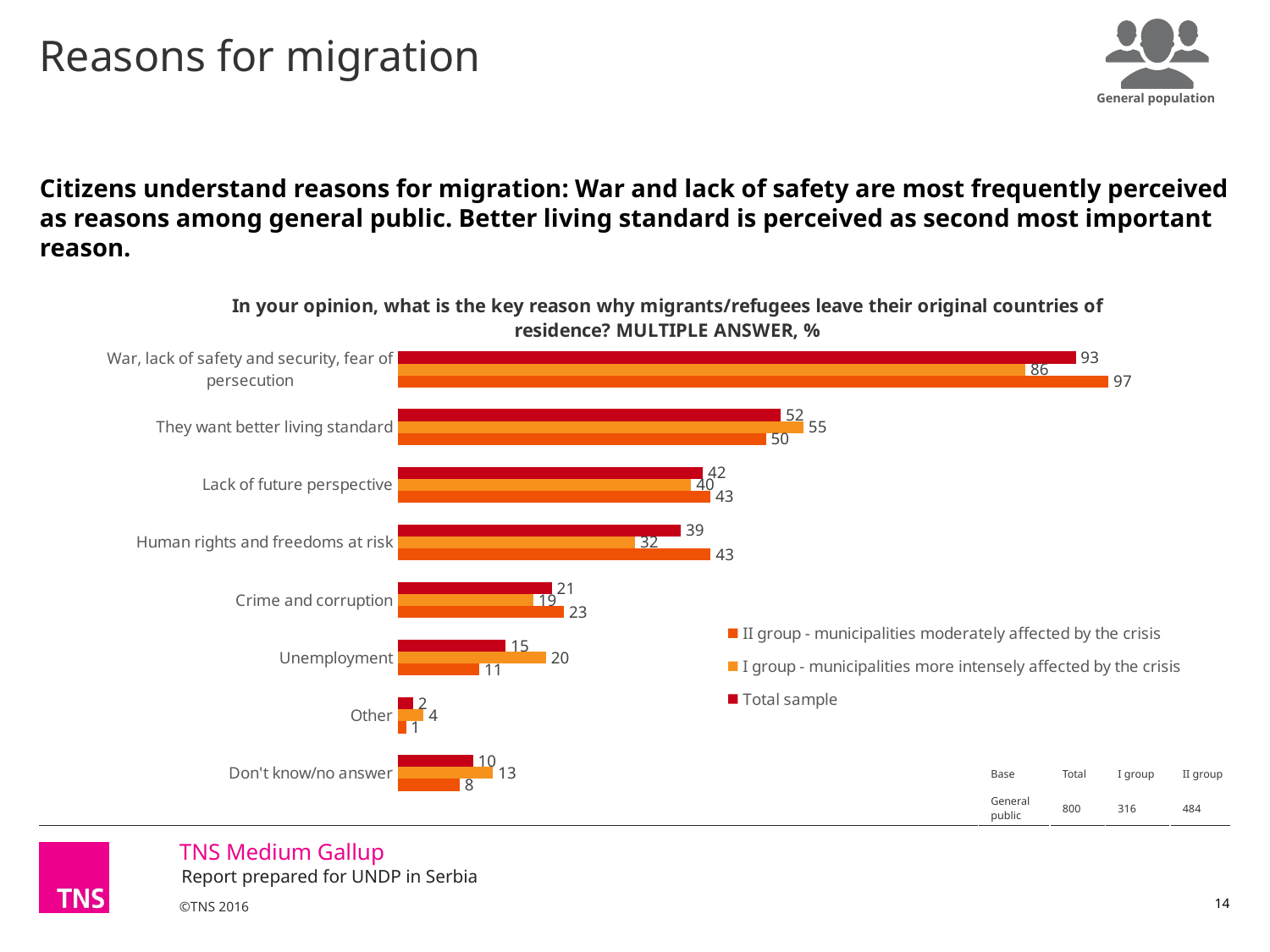
How many reason categories are shown on the chart? 8 What is the value for "They want better living standard" in the I group (municipalities more intensely affected by the crisis)? 55 Which category has the highest Total sample value? War, lack of safety and security, fear of persecution Which category has the lowest Total sample value? Other What is the Total sample value for "Unemployment"? 15 What is the difference between the II group and I group values for "War, lack of safety and security, fear of persecution"? 11 What kind of chart is shown on the slide? Bar chart For "Unemployment", which is larger: the I group value or the II group value? I group What is the Total sample value for "War, lack of safety and security, fear of persecution"? 93 What is the II group value for "Human rights and freedoms at risk"? 43 How many series does the legend list? 3 What is the difference between the Total sample values for "Crime and corruption" and "Don't know/no answer"? 11